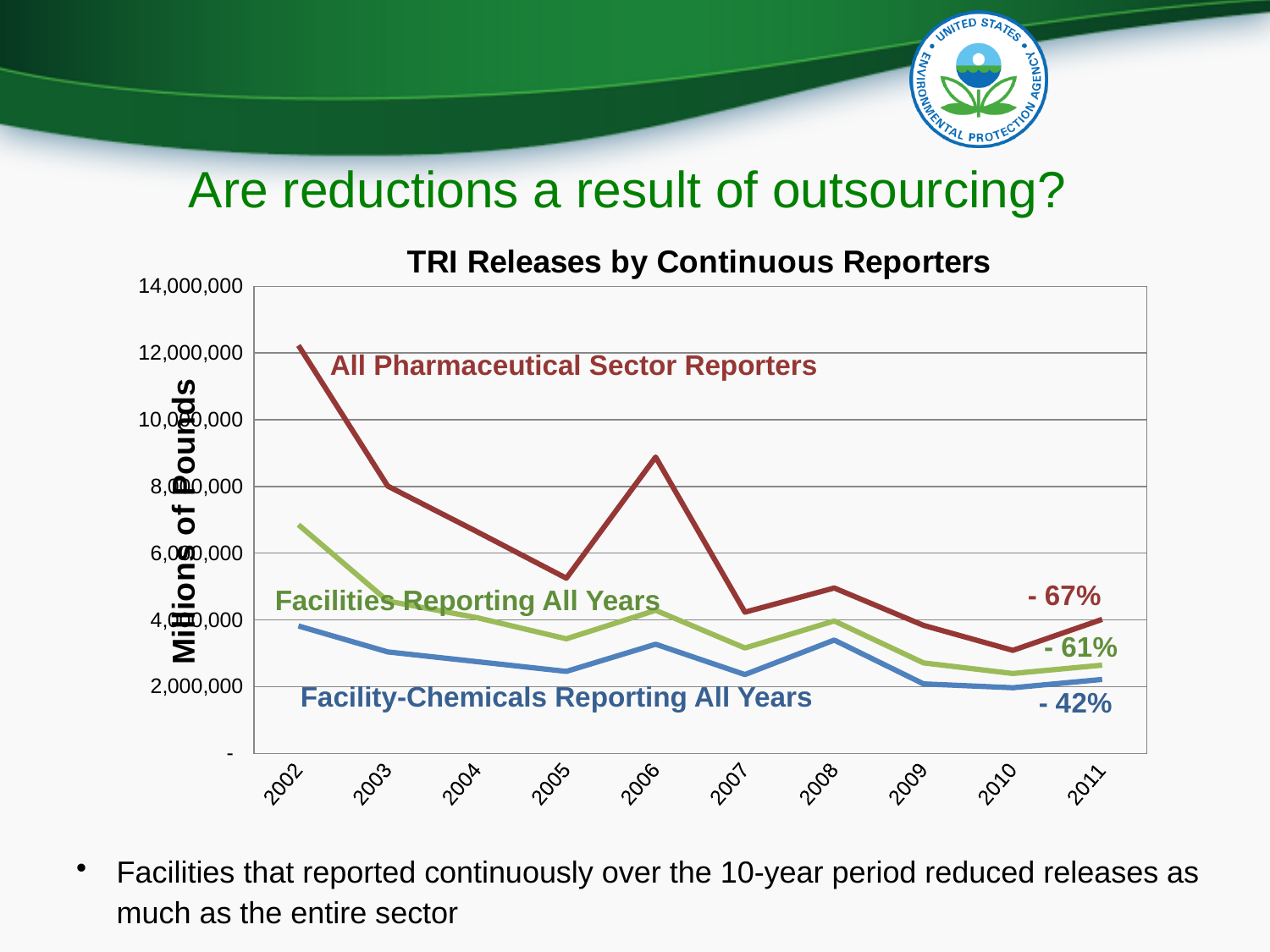
What percentage change is labelled on the chart for Facility-Chemicals Reporting All Years? - 42% How many years are shown along the x axis of the chart? 10 How many data series are plotted on the chart? 3 What kind of chart is shown on the slide? Line chart Is the value for All Pharmaceutical Sector Reporters in 2002 greater or less than 10,000,000? greater Is the value for Facilities Reporting All Years in 2002 greater or less than 6,000,000? greater Is the value for All Pharmaceutical Sector Reporters in 2006 greater or less than 8,000,000? greater In 2006, which is larger: All Pharmaceutical Sector Reporters or Facilities Reporting All Years? All Pharmaceutical Sector Reporters In which year is the All Pharmaceutical Sector Reporters line at its highest? 2002 Does the All Pharmaceutical Sector Reporters line rise or fall overall from 2002 to 2011? Fall What is the title of the chart? TRI Releases by Continuous Reporters